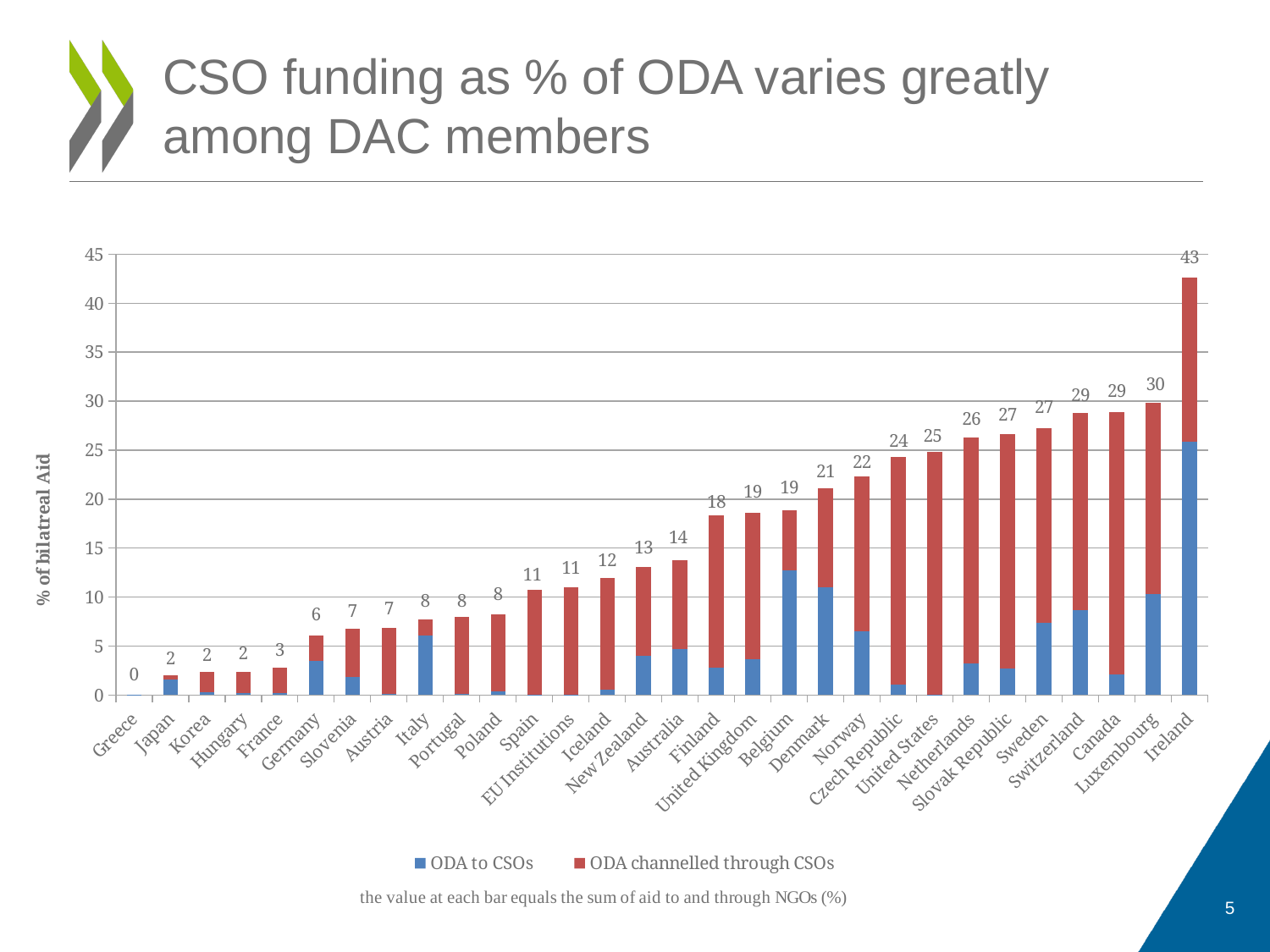
Which country has the highest total CSO funding as % of bilateral aid? Ireland How many series does the legend list? 2 What is the total value labelled for Germany? 6 Do the labelled totals rise or fall from left to right along the x axis? Rise What is the total value labelled for Ireland? 43 Which has a larger labelled total, Denmark or Spain? Denmark How many countries or institutions are shown on the x axis? 30 What is the total value labelled for Finland? 18 What kind of chart is shown on the slide? Stacked bar chart What is the difference between the labelled totals for Ireland and Luxembourg? 13 Is the ODA to CSOs (blue) value for Belgium greater or less than 10? greater Which country has the lowest total, labelled 0? Greece